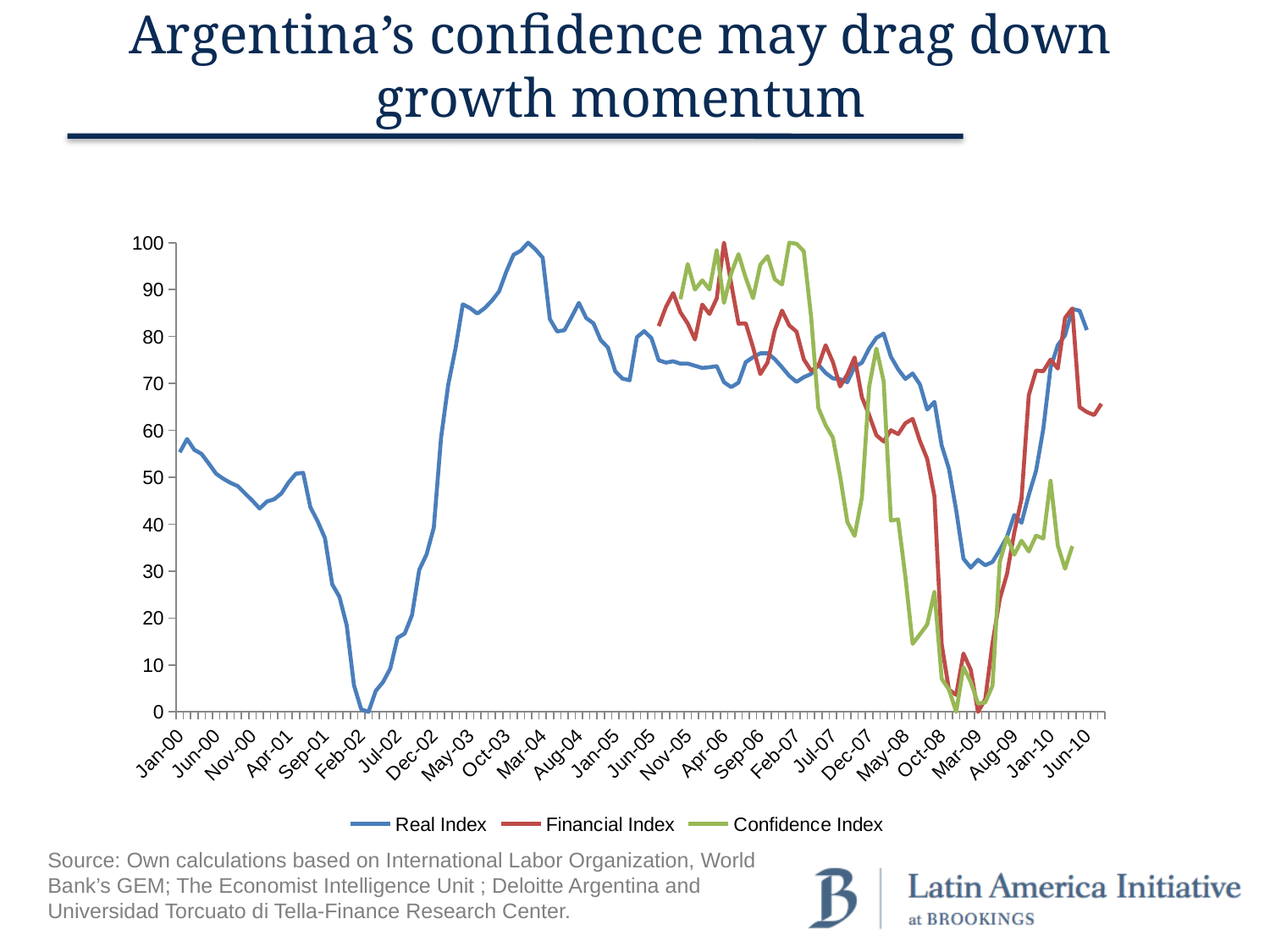
How many series does the legend list? 3 What kind of chart is shown on the slide? line chart Is the value of the Real Index around Mar-04 greater or less than 90? greater Is the value of the Confidence Index around Mar-09 greater or less than 10? less What is the title of the slide containing the chart? Argentina's confidence may drag down growth momentum Which series is drawn in green? Confidence Index Is the value of the Real Index at Jan-00 greater or less than 50? greater Does the Real Index rise or fall between Jan-00 and Feb-02? fall